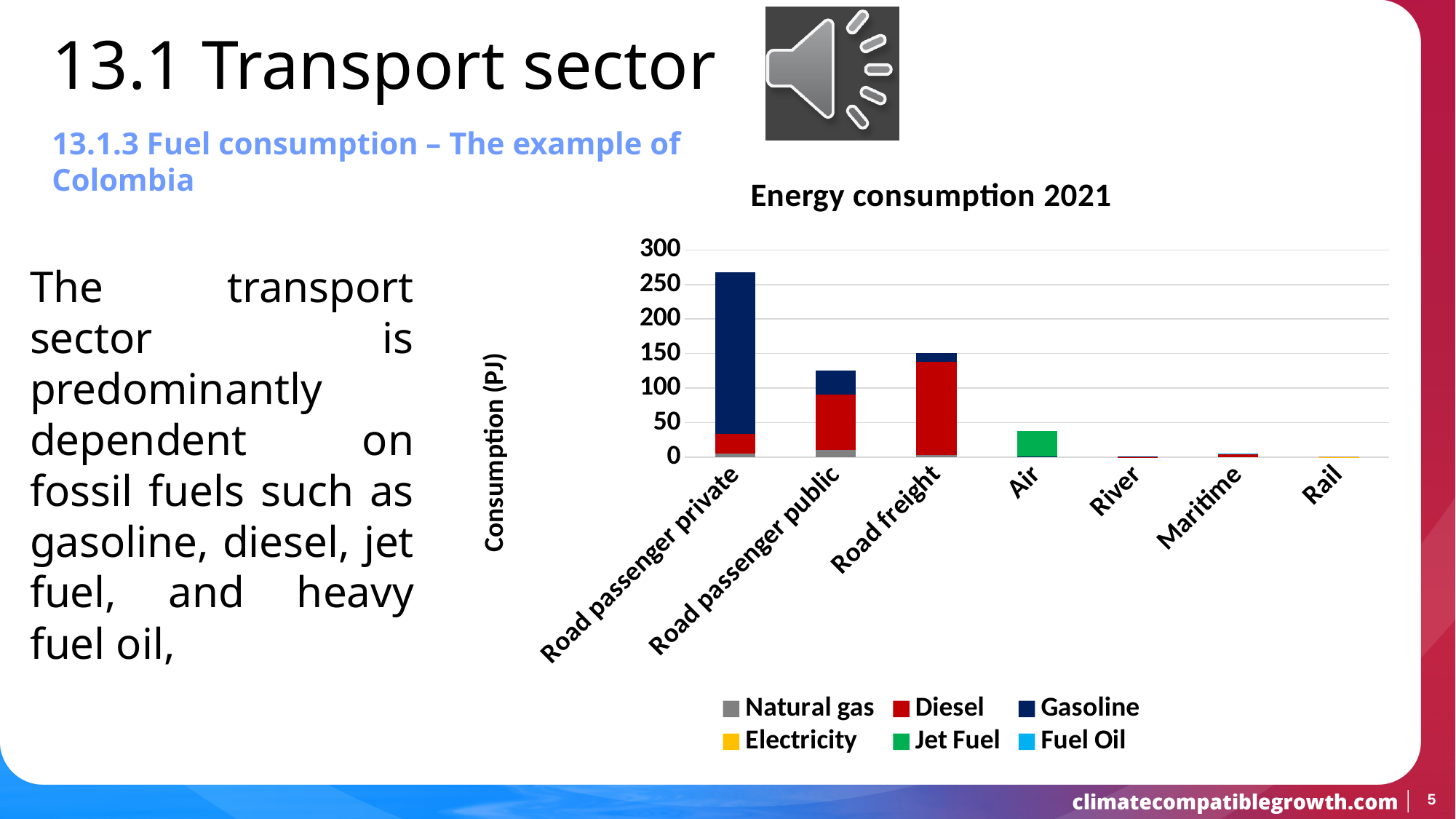
How many transport categories are shown on the x axis of the chart? 7 Is the total value for Road freight greater or less than 100? greater What is the label of the y axis of the chart? Consumption (PJ) How many series does the chart legend list? 6 What type of chart is shown on the slide? Stacked bar chart Is the total value for Air greater or less than 50? less Is the total value for Road passenger public greater or less than 100? greater Which has a larger total energy consumption, Air or Road freight? Road freight Which has a larger total energy consumption, Road passenger private or Road freight? Road passenger private Which transport category has the highest total energy consumption in the chart? Road passenger private What is the title of the chart? Energy consumption 2021